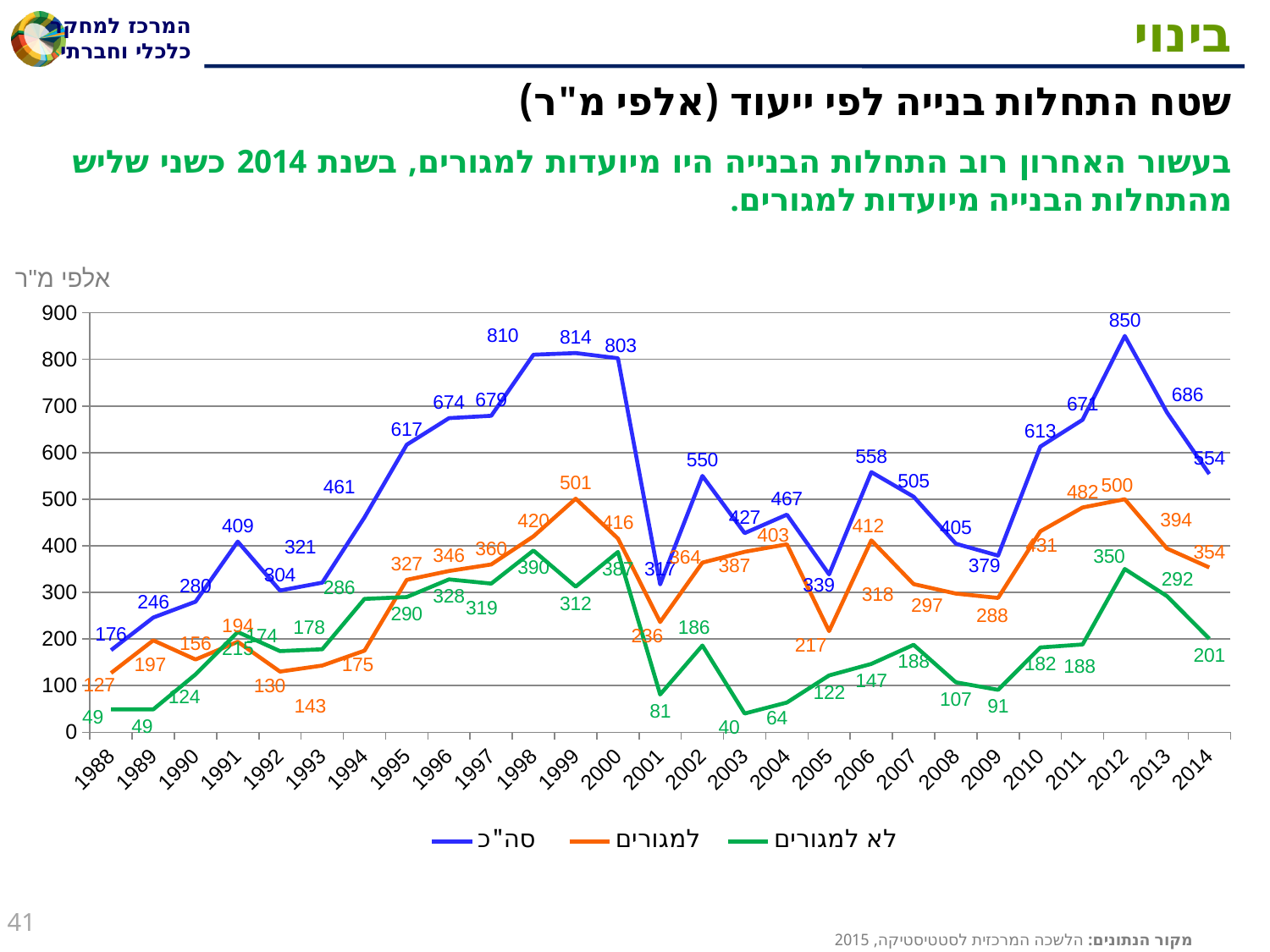
In which year does the סה"כ (total) series reach its highest value? 2012 What is the difference between the למגורים (residential) value and the לא למגורים (non-residential) value in 2012? 150 What is the value of the סה"כ (total) series in 2012? 850 In which year does the לא למגורים (non-residential) series reach its lowest value? 2003 How many years are plotted along the x axis? 27 What is the value of the למגורים (residential) series in 1999? 501 Which series has the larger value in 2000: למגורים (residential) or לא למגורים (non-residential)? למגורים How many series does the legend list? 3 Does the סה"כ (total) series rise or fall from 2012 to 2014? fall Is the value of the סה"כ (total) series in 2001 greater or less than 400? less What is the value of the לא למגורים (non-residential) series in 2003? 40 What type of chart is shown on the slide? line chart